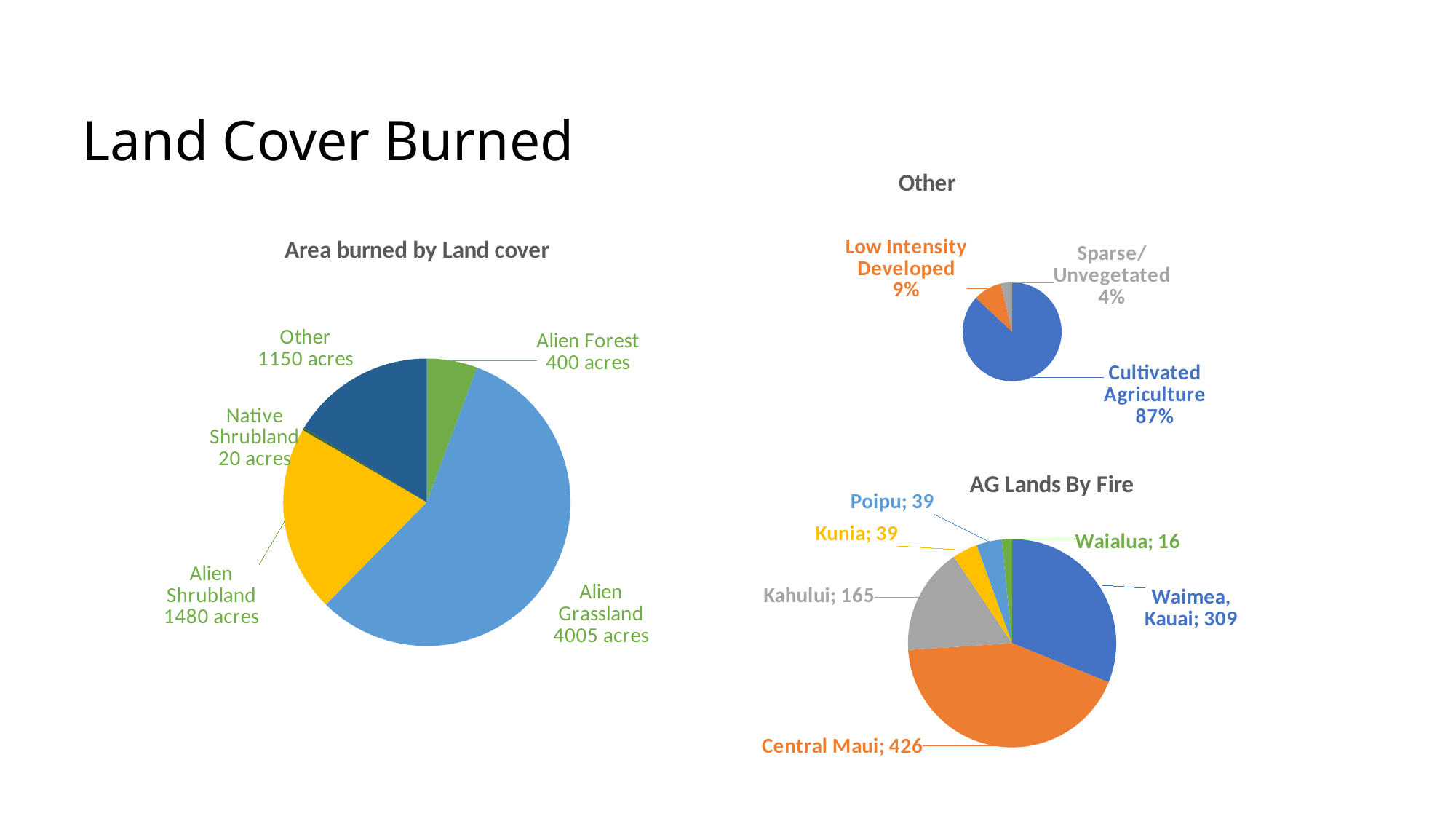
What type of chart is the 'Area burned by Land cover' chart? Pie chart In the 'Other' chart, which is larger: Low Intensity Developed or Sparse/Unvegetated? Low Intensity Developed In the 'Other' chart, which category has the smallest share? Sparse/Unvegetated In the 'AG Lands By Fire' chart, which fire has the highest value? Central Maui In the 'Area burned by Land cover' chart, how many land cover categories are shown? 5 In the 'AG Lands By Fire' chart, what is the value for Kahului? 165 In the 'Area burned by Land cover' chart, how many acres of Alien Grassland were burned? 4005 acres In the 'Area burned by Land cover' chart, which land cover category has the smallest area burned? Native Shrubland In the 'Area burned by Land cover' chart, what is the difference in acres burned between Alien Shrubland and Other? 330 acres In the 'Other' chart, what percentage is Cultivated Agriculture? 87% In the 'AG Lands By Fire' chart, how many fires are shown? 6 In the 'AG Lands By Fire' chart, what is the difference between Central Maui and Waimea, Kauai? 117